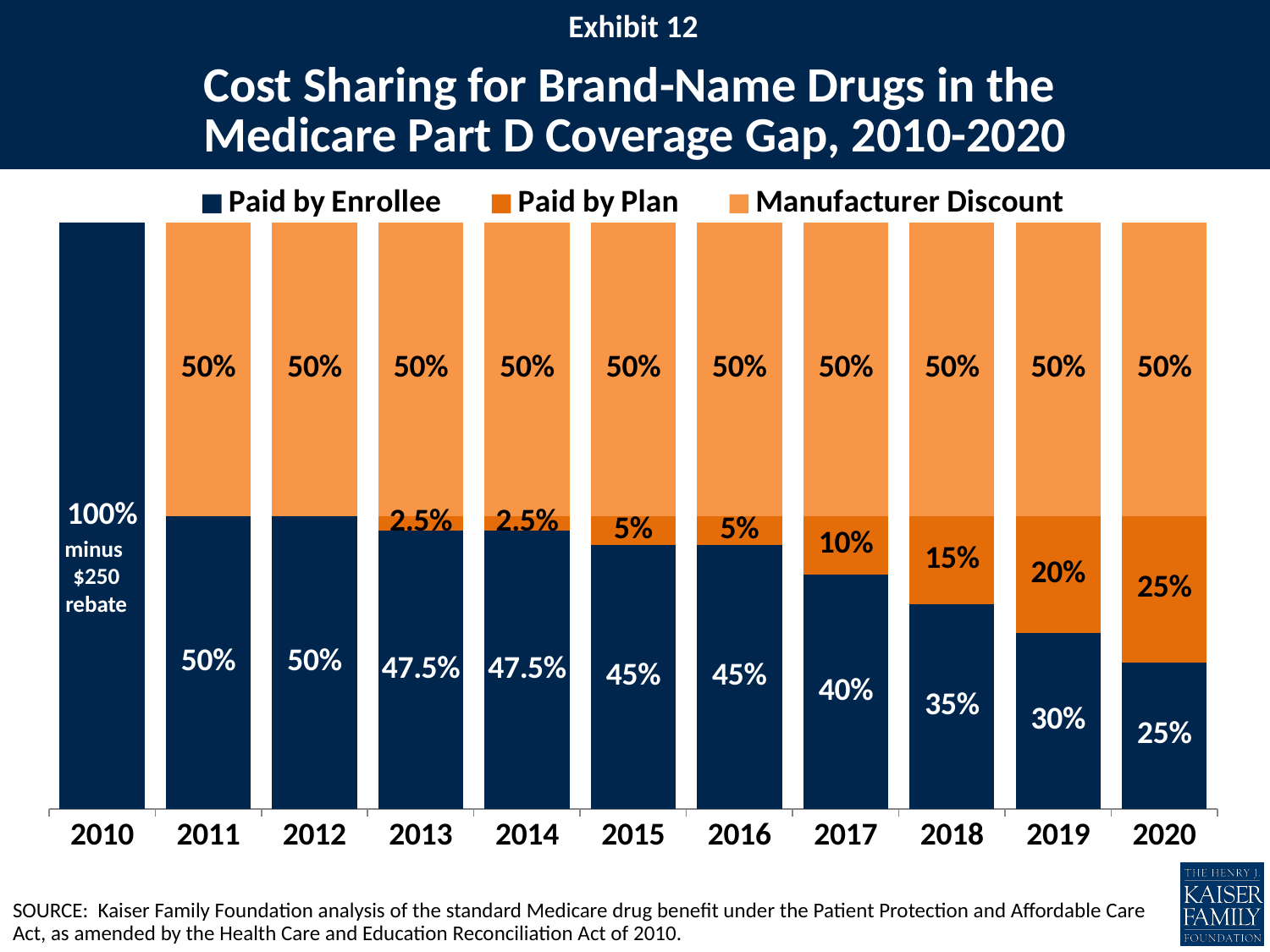
What share is paid by the enrollee in 2013? 47.5% What kind of chart is this? Stacked bar chart In which year is the share paid by the enrollee lowest? 2020 What share is paid by the plan in 2018? 15% In which year after 2010 is the share paid by the plan highest? 2020 Which is larger in 2017: the share paid by the enrollee or the share paid by the plan? Paid by Enrollee What share is paid by the enrollee in 2020? 25% How many series does the legend list? 3 How many years are shown on the x axis? 11 Does the share paid by the enrollee rise or fall from 2011 to 2020? Fall What is the manufacturer discount in 2015? 50% What is the difference between the share paid by the enrollee in 2011 and in 2020? 25%